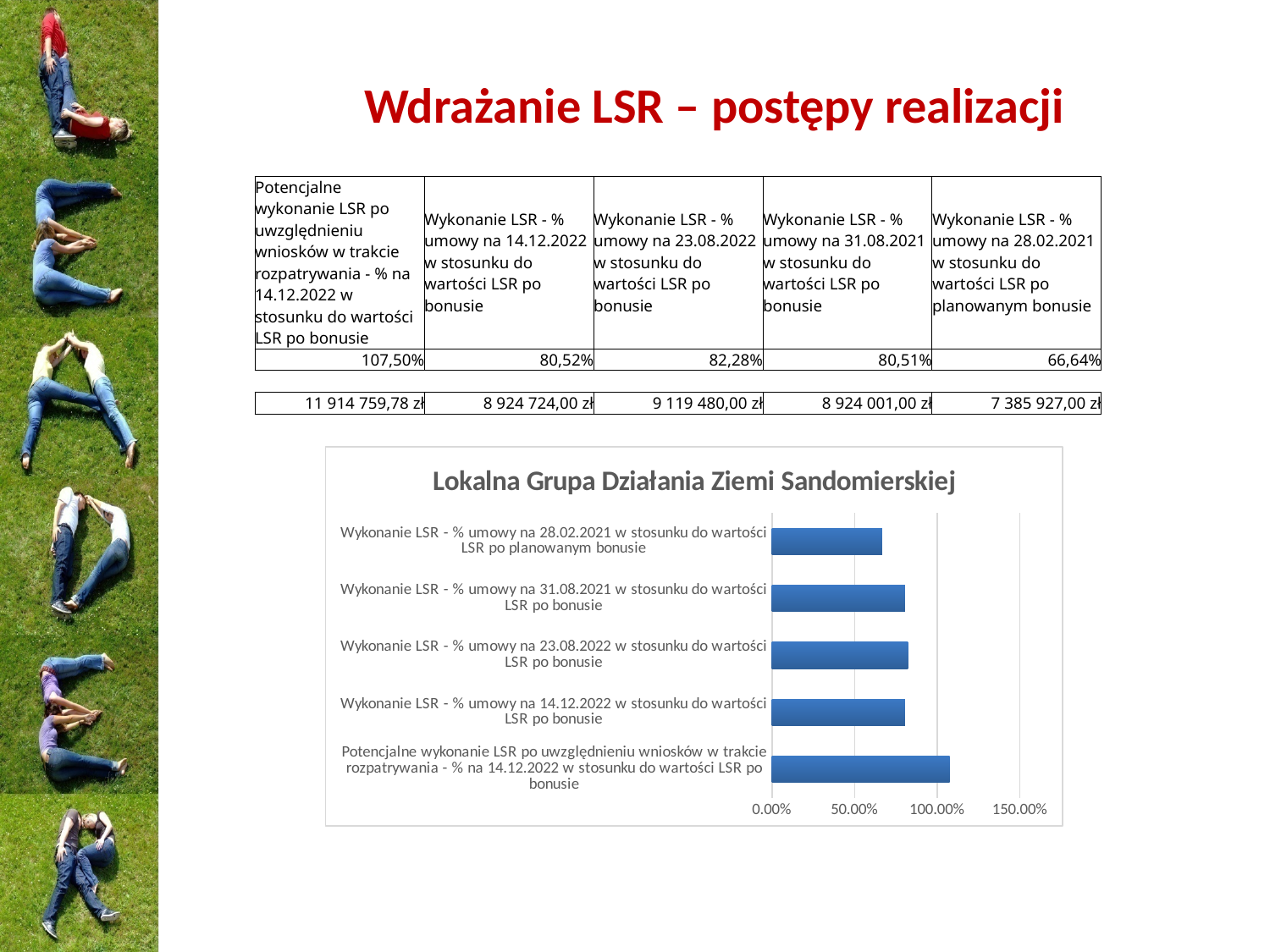
Which is larger: the bar for 'Wykonanie LSR - % umowy na 23.08.2022 w stosunku do wartości LSR po bonusie' or the bar for 'Wykonanie LSR - % umowy na 28.02.2021 w stosunku do wartości LSR po planowanym bonusie'? Wykonanie LSR - % umowy na 23.08.2022 w stosunku do wartości LSR po bonusie Is the value for 'Potencjalne wykonanie LSR po uwzględnieniu wniosków w trakcie rozpatrywania - % na 14.12.2022 w stosunku do wartości LSR po bonusie' greater or less than 100.00%? greater What is the highest tick value shown on the horizontal axis of the chart? 150.00% What type of chart is shown on the slide? bar chart What is the title of the chart? Lokalna Grupa Działania Ziemi Sandomierskiej Which category has the longest bar in the chart? Potencjalne wykonanie LSR po uwzględnieniu wniosków w trakcie rozpatrywania - % na 14.12.2022 w stosunku do wartości LSR po bonusie Which category has the shortest bar in the chart? Wykonanie LSR - % umowy na 28.02.2021 w stosunku do wartości LSR po planowanym bonusie Is the value for 'Wykonanie LSR - % umowy na 23.08.2022 w stosunku do wartości LSR po bonusie' greater or less than 50.00%? greater How many bars does the chart contain? 5 Is the value for 'Wykonanie LSR - % umowy na 31.08.2021 w stosunku do wartości LSR po bonusie' greater or less than 100.00%? less